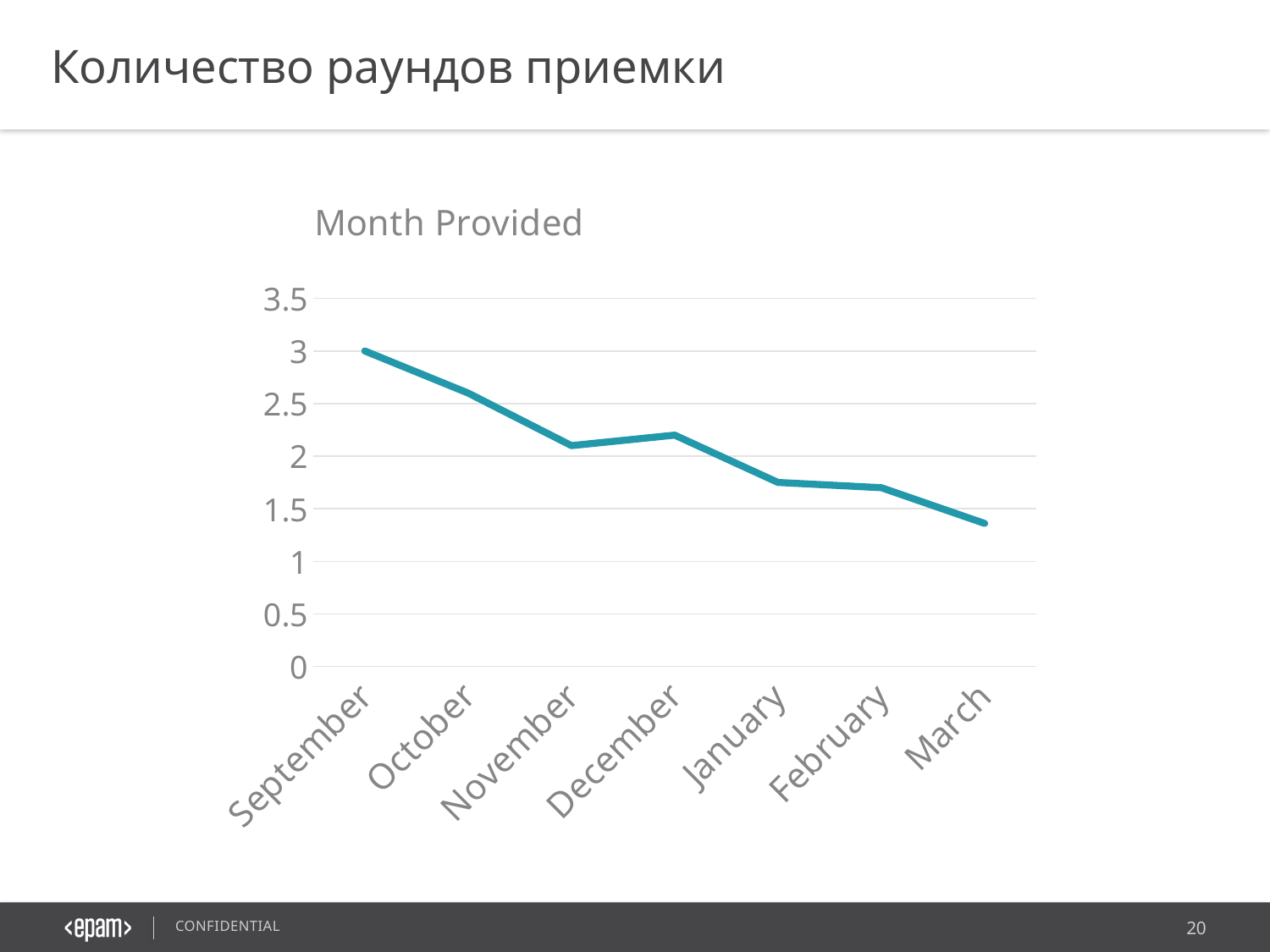
Is the value for November greater or less than 2.5? less Is the value for December greater or less than 2? greater Do the values generally rise or fall from September to March? fall Which month has the highest value? September Is the value for January greater or less than 2? less What is the title of the chart? Month Provided How many months are plotted along the x axis? 7 Which month has the lowest value? March Which is larger, the value for October or the value for January? October What kind of chart is shown on the slide? line chart What is the value for September? 3